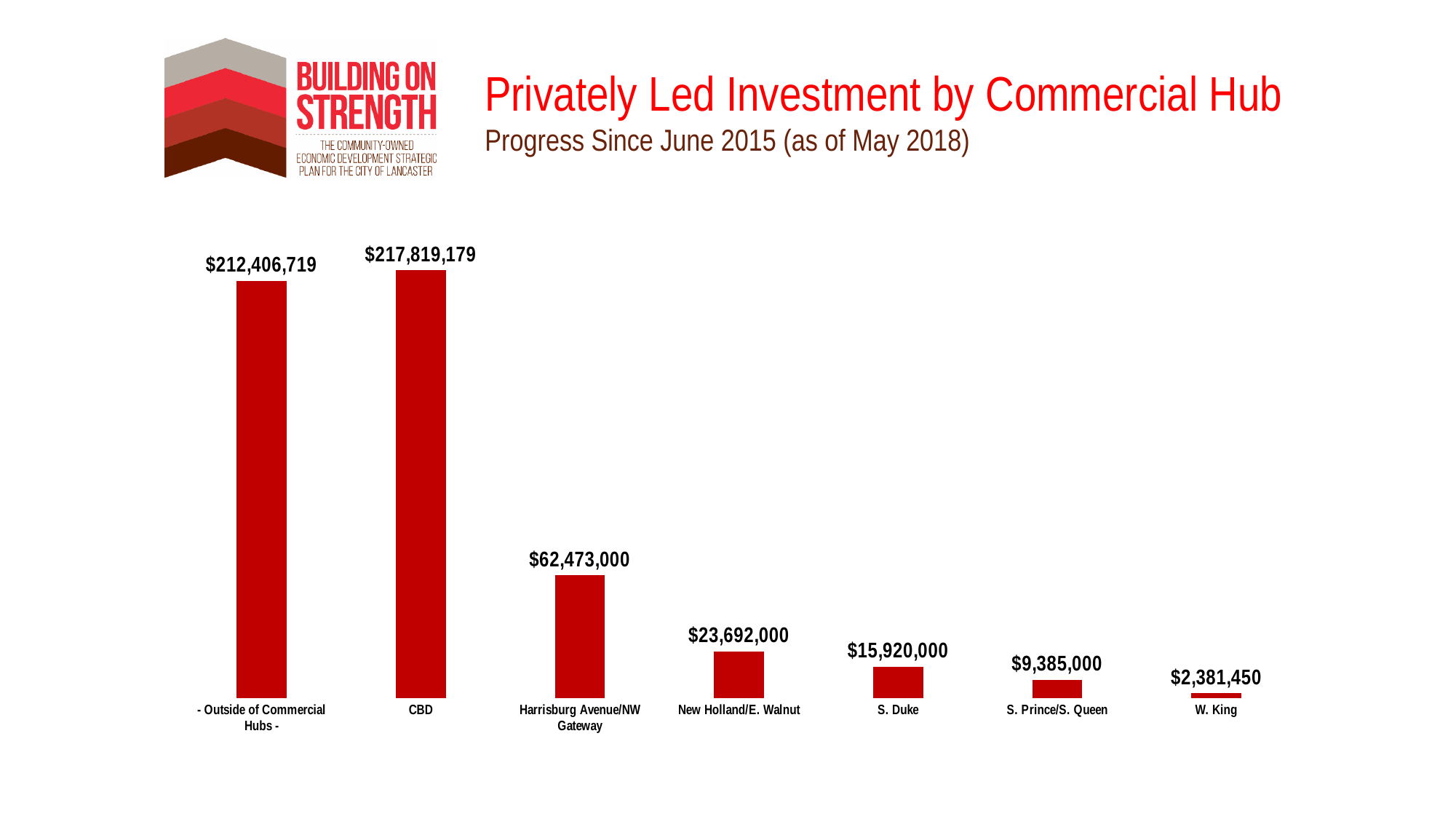
What is the privately led investment value for W. King? $2,381,450 What is the privately led investment value for S. Duke? $15,920,000 What is the title of the chart on the slide? Privately Led Investment by Commercial Hub Which commercial hub has the lowest privately led investment? W. King Which has a larger privately led investment, S. Duke or S. Prince/S. Queen? S. Duke What is the difference between the investment for CBD and for Outside of Commercial Hubs? $5,412,460 How many commercial hub categories are shown in the chart? 7 What is the privately led investment value for Harrisburg Avenue/NW Gateway? $62,473,000 What is the difference between the investment for Harrisburg Avenue/NW Gateway and for New Holland/E. Walnut? $38,781,000 Which commercial hub has the highest privately led investment? CBD What kind of chart is shown on the slide? Bar chart What is the privately led investment value for CBD? $217,819,179